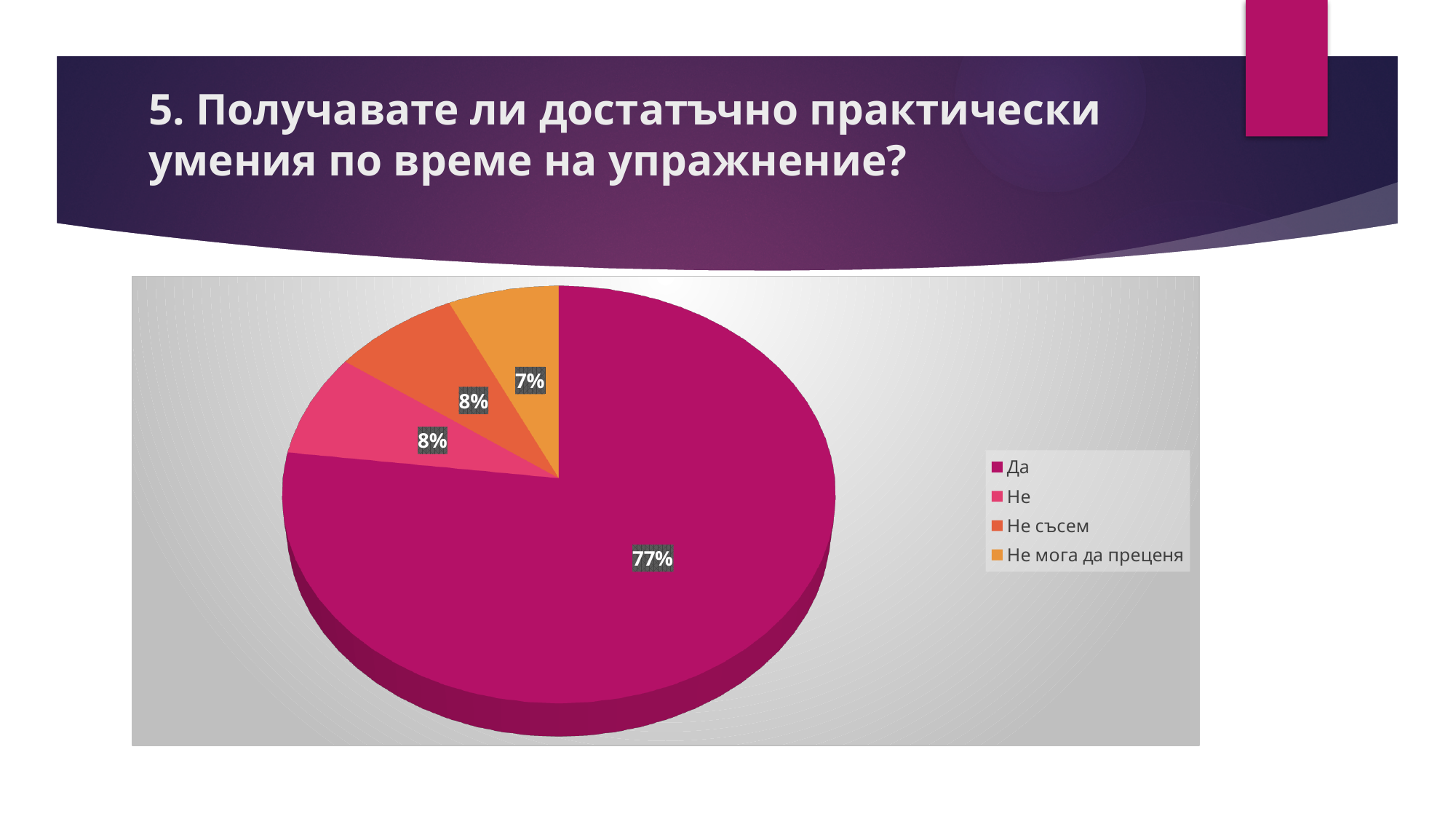
What is the difference in percentage points between the "Да" slice and the "Не съсем" slice? 69 What percentage of the pie is the "Не съсем" slice? 8% Which is larger, the share for "Да" or the share for "Не"? Да What percentage of the pie is the "Не мога да преценя" slice? 7% What percentage of the pie is the "Да" slice? 77% What kind of chart is shown on the slide? pie chart What percentage of the pie is the "Не" slice? 8% Which category has the smallest share of the pie? Не мога да преценя How many slices does the pie chart have? 4 How many entries does the legend list? 4 Which category has the largest share of the pie? Да What colour is the "Не мога да преценя" slice? orange